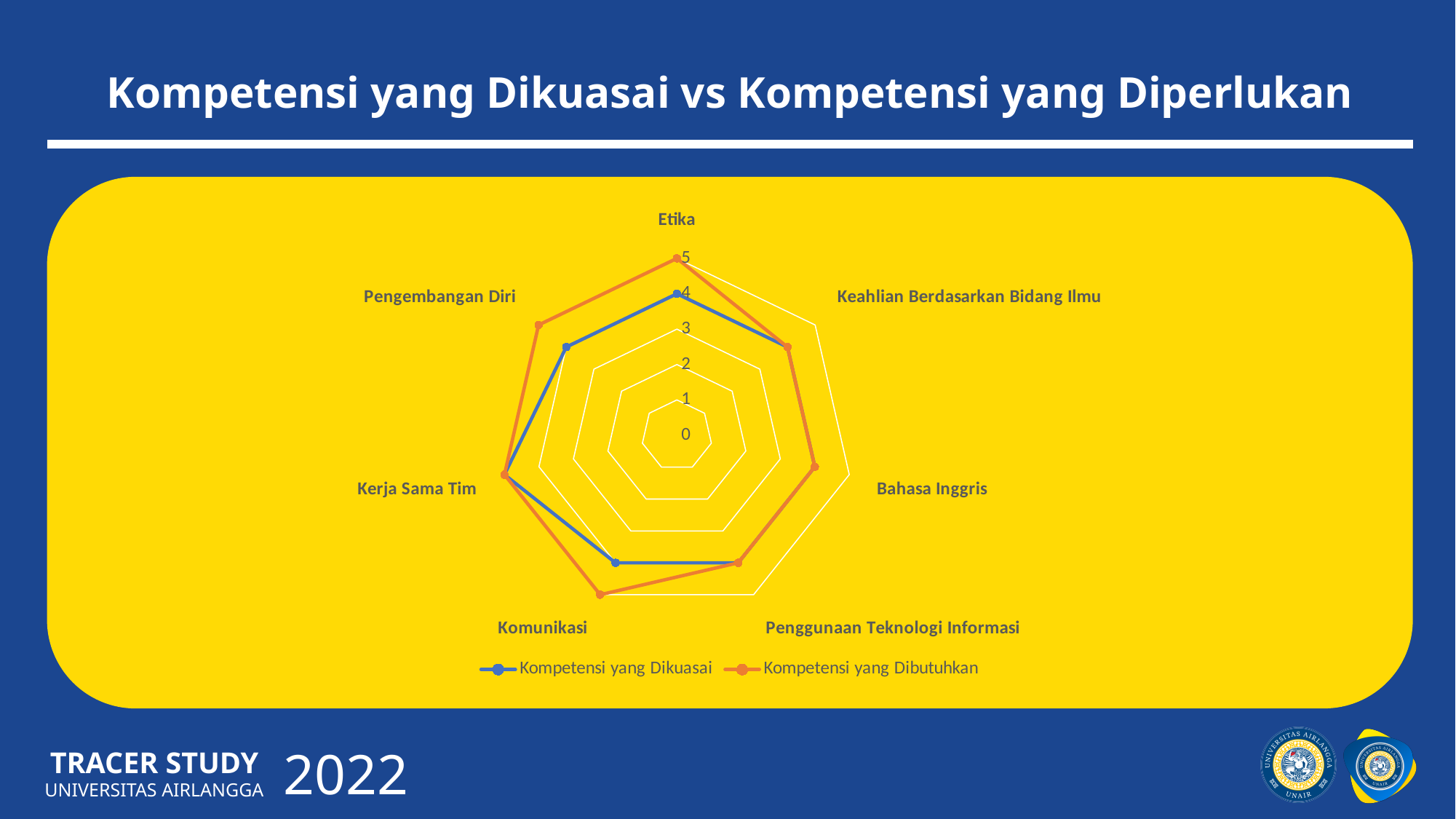
What kind of chart is shown on the slide? Radar chart For Pengembangan Diri, which series has the larger value: Kompetensi yang Dikuasai or Kompetensi yang Dibutuhkan? Kompetensi yang Dibutuhkan How many competency categories are plotted on the radar chart? 7 What are the two series named in the legend? Kompetensi yang Dikuasai and Kompetensi yang Dibutuhkan What is the title of the slide containing the chart? Kompetensi yang Dikuasai vs Kompetensi yang Diperlukan How many series does the legend list? 2 What is the value of Kompetensi yang Dibutuhkan for Etika? 5 What is the value of Kompetensi yang Dikuasai for Etika? 4 Is the Kompetensi yang Dikuasai value for Kerja Sama Tim greater or less than 4? greater